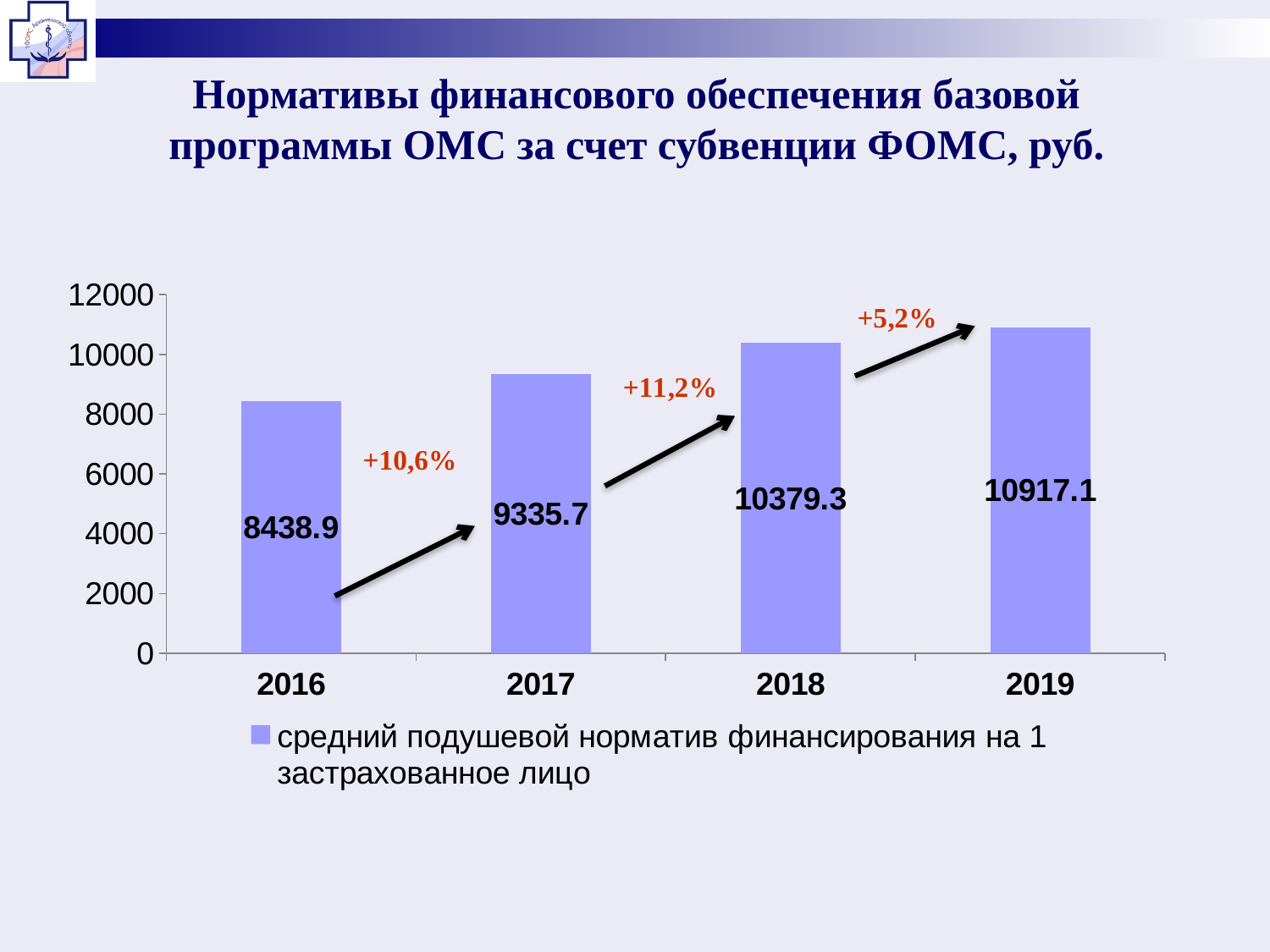
What is the value for 2019? 10917.1 Do the values rise or fall from 2016 to 2019? rise Which year has the highest value? 2019 What is the value for 2018? 10379.3 Which is larger, the value for 2017 or the value for 2018? 2018 What is the difference between the values for 2019 and 2018? 537.8 What kind of chart is shown on the slide? bar chart Which year has the lowest value? 2016 How many years are shown on the x axis? 4 Is the value for 2017 greater or less than 10000? less What is the value for 2016? 8438.9 What is the difference between the values for 2017 and 2016? 896.8